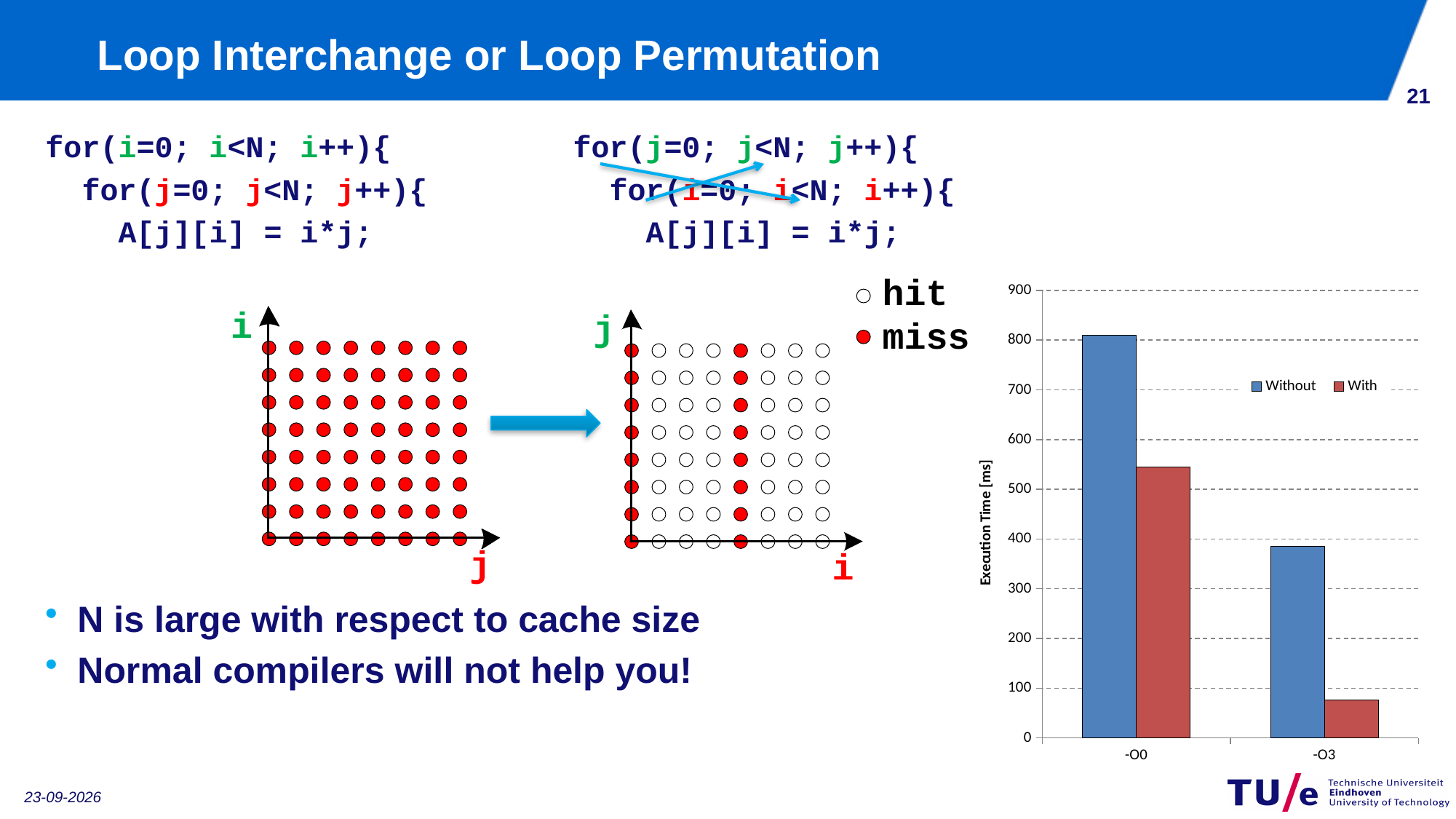
Is the value for With at -O3 greater or less than 100? less How many series does the chart's legend list? 2 What is the label of the chart's vertical axis? Execution Time [ms] What kind of chart is shown on the slide? bar chart Which series and category has the lowest execution time in the chart? With, -O3 Which series and category has the highest execution time in the chart? Without, -O0 How many categories are shown on the x axis of the chart? 2 Is the value for Without at -O3 greater or less than 400? less For -O0, which series has the larger execution time, Without or With? Without For -O3, which series has the larger execution time, Without or With? Without Does the execution time for the Without series rise or fall from -O0 to -O3? fall